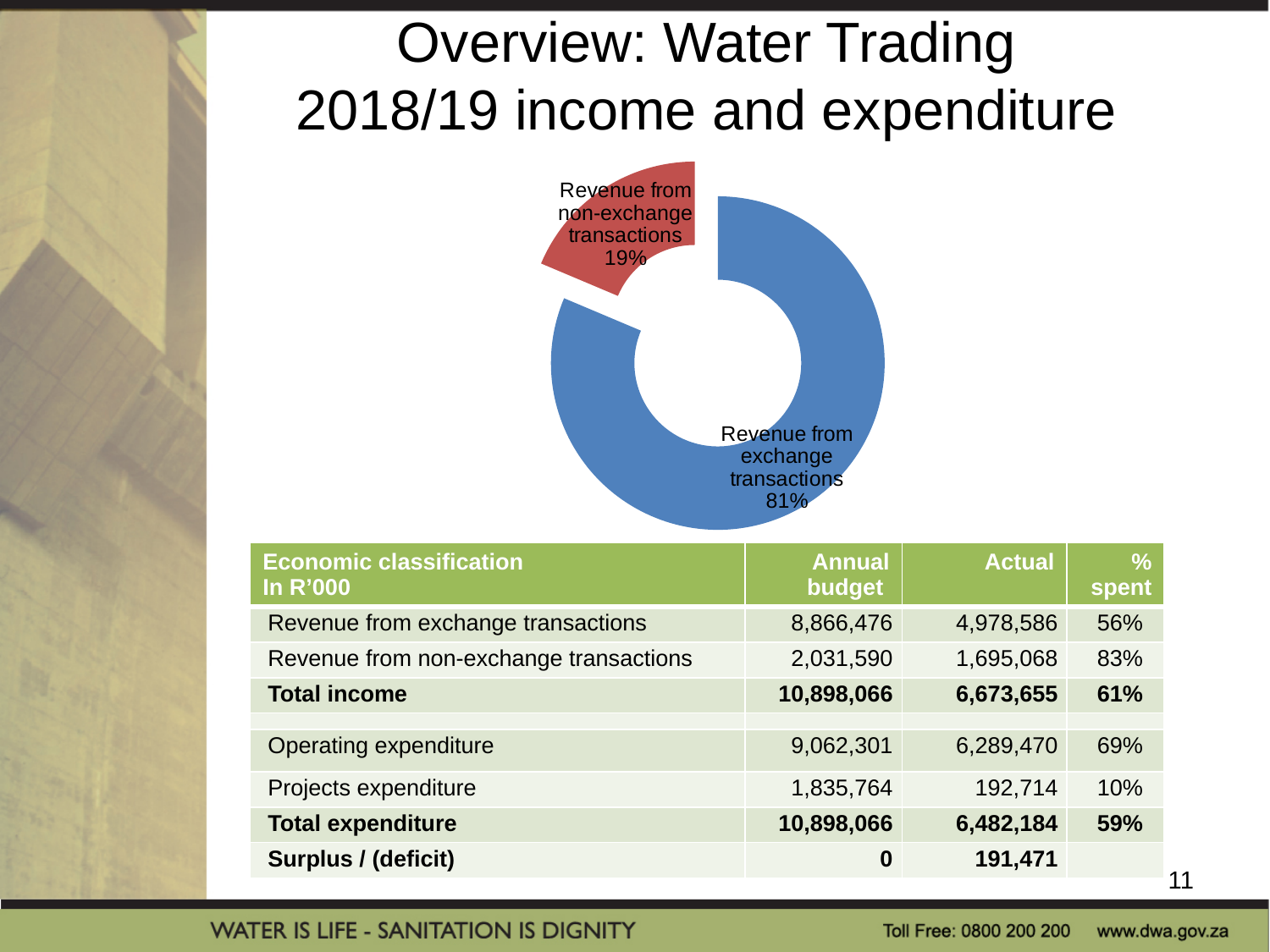
Which is larger in the doughnut chart: Revenue from exchange transactions or Revenue from non-exchange transactions? Revenue from exchange transactions What kind of chart is shown on the slide? doughnut chart Which slice of the doughnut chart is the largest? Revenue from exchange transactions What share of the doughnut chart is Revenue from exchange transactions? 81% What share of the doughnut chart is Revenue from non-exchange transactions? 19% Which slice of the doughnut chart is the smallest? Revenue from non-exchange transactions How many slices does the doughnut chart have? 2 What colour is the Revenue from non-exchange transactions slice in the doughnut chart? red What colour is the Revenue from exchange transactions slice in the doughnut chart? blue By how many percentage points does the Revenue from exchange transactions slice exceed the Revenue from non-exchange transactions slice? 62 percentage points